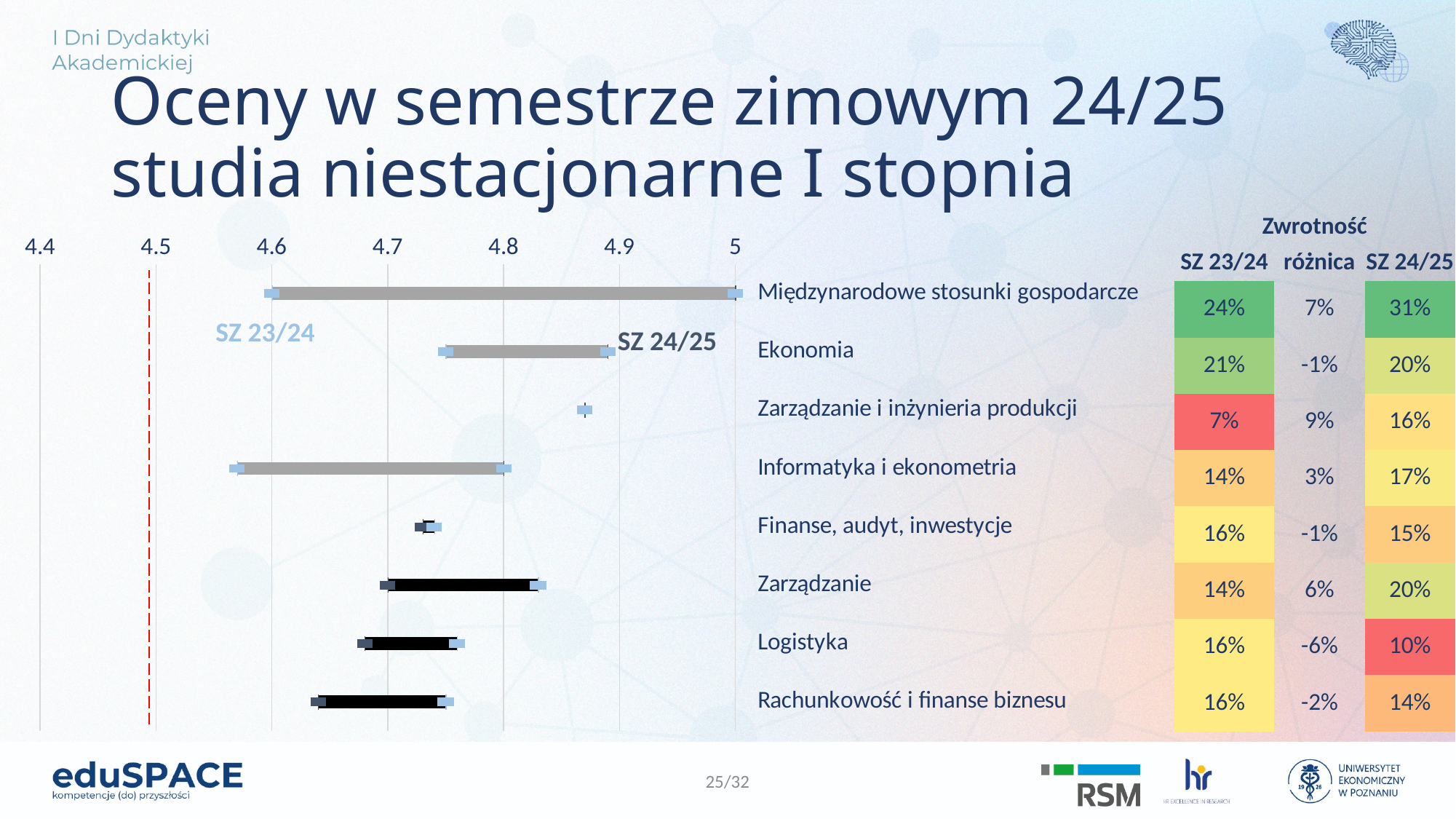
What is the title of the slide containing the chart? Oceny w semestrze zimowym 24/25 studia niestacjonarne I stopnia Is the SZ 23/24 value for Informatyka i ekonometria greater or less than 4.7? less Is the value for Zarządzanie i inżynieria produkcji greater or less than 4.8? greater How many study programmes (categories) are shown on the chart? 8 Which programme has the highest SZ 24/25 value on the chart? Międzynarodowe stosunki gospodarcze What are the two series labelled on the chart? SZ 23/24 and SZ 24/25 Is the SZ 23/24 value for Międzynarodowe stosunki gospodarcze greater or less than 4.7? less At which axis value is the red dashed vertical line drawn on the chart? 4.5 Which is larger: the SZ 24/25 value for Międzynarodowe stosunki gospodarcze or the SZ 24/25 value for Ekonomia? Międzynarodowe stosunki gospodarcze